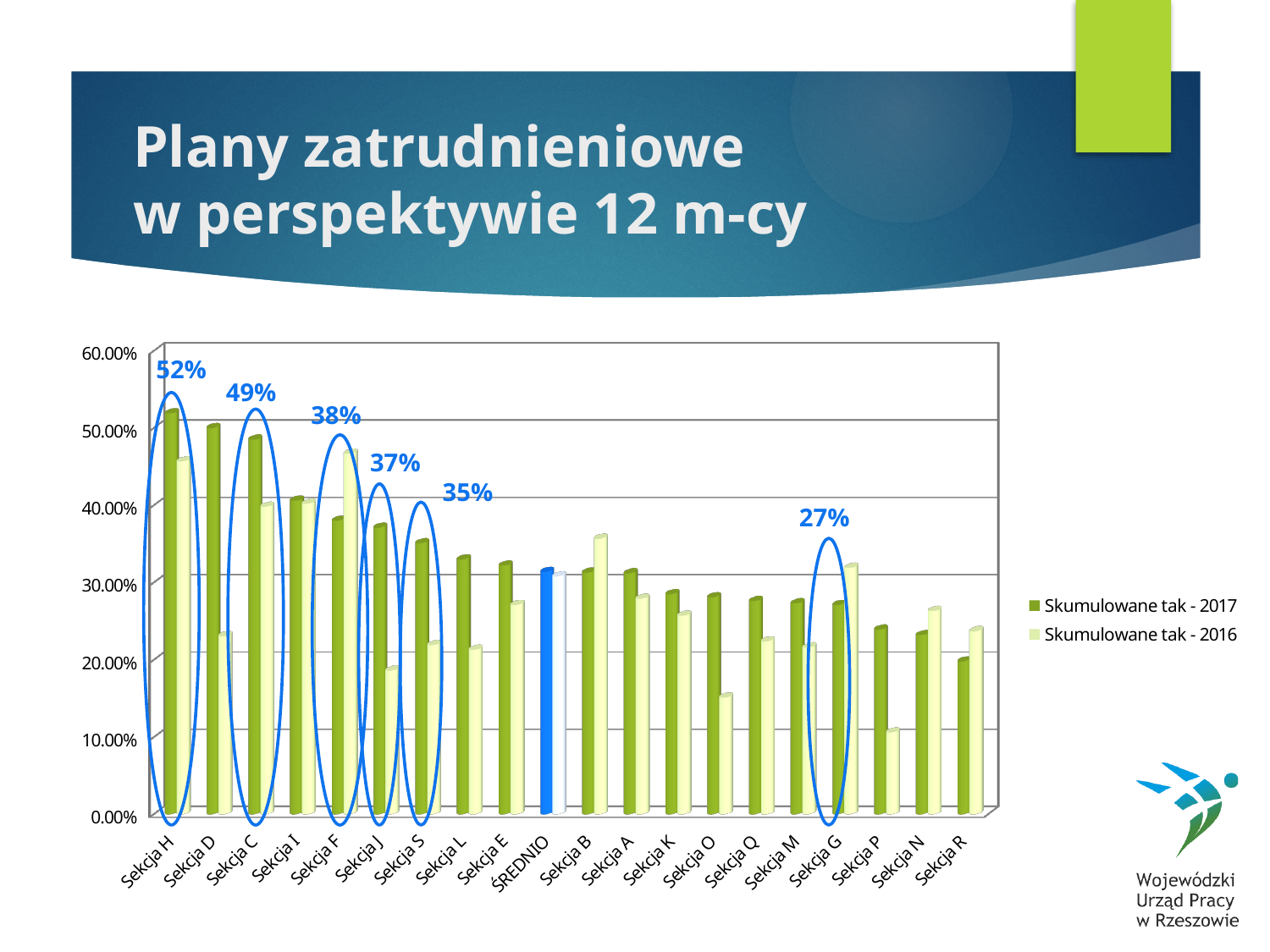
For Sekcja B, which series has the larger value, 'Skumulowane tak - 2017' or 'Skumulowane tak - 2016'? Skumulowane tak - 2016 Which category has the lowest value in the 'Skumulowane tak - 2017' series? Sekcja R Do the 'Skumulowane tak - 2017' values generally rise or fall from left to right along the x axis? fall How many categories are shown along the x axis? 20 Is the 'Skumulowane tak - 2016' value for Sekcja O greater or less than 20%? less How many series does the legend list? 2 What is the labelled value for Sekcja H in the 'Skumulowane tak - 2017' series? 52% What kind of chart is shown on the slide? bar chart What is the labelled value for Sekcja C in the 'Skumulowane tak - 2017' series? 49% What is the difference between the labelled 2017 values for Sekcja H and Sekcja G? 25 percentage points Is the 'Skumulowane tak - 2016' value for Sekcja B greater or less than 30%? greater What is the labelled value for Sekcja G in the 'Skumulowane tak - 2017' series? 27%